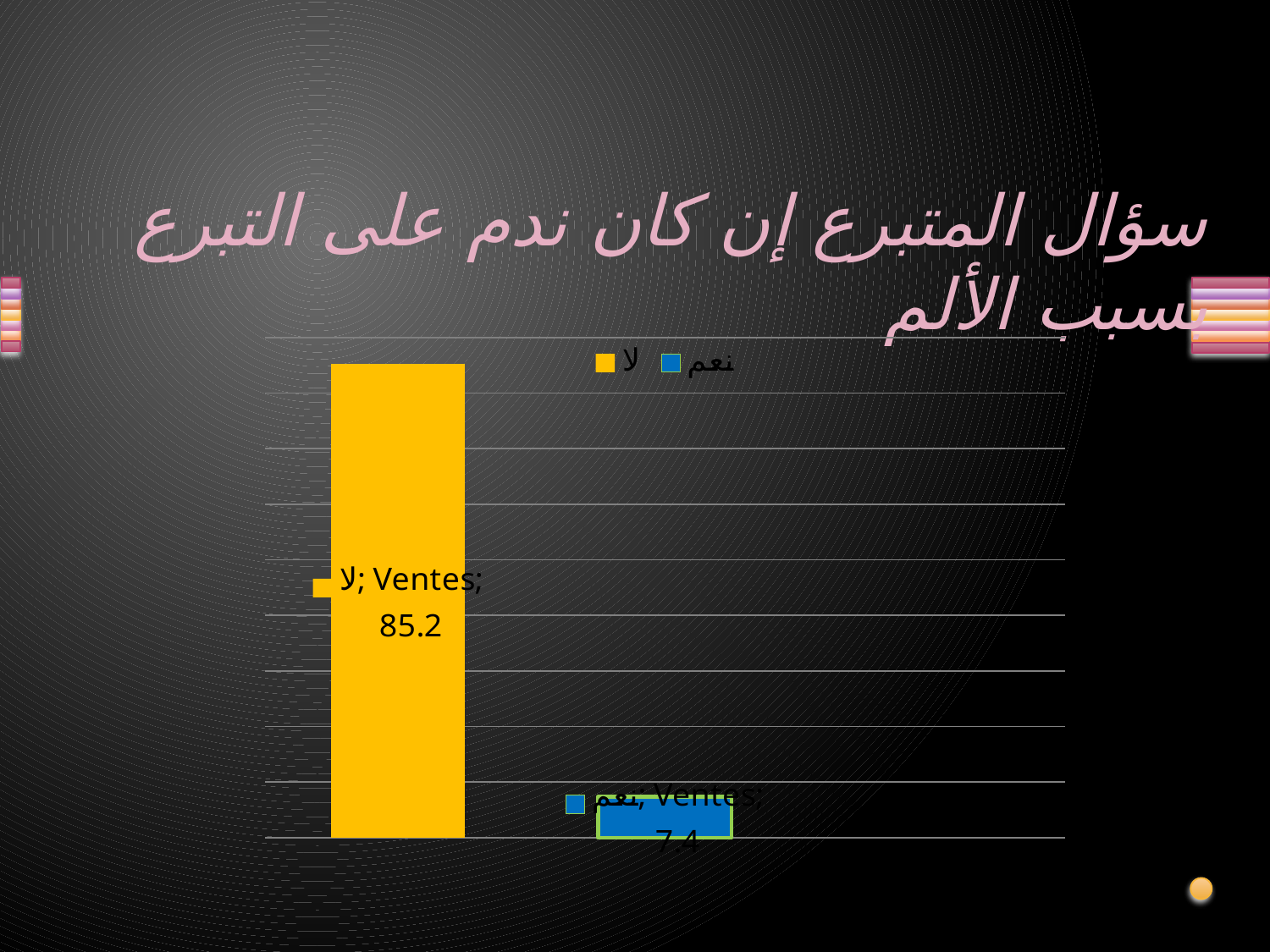
What kind of chart is shown on the slide? Bar chart What is the value for the category "لا" in the chart? 85.2 What colour is the bar for "لا"? Yellow What is the value for the category "نعم" in the chart? 7.4 Which category has the lowest value in the chart? نعم Which category has the highest value in the chart? لا What series name appears in the data labels of the chart? Ventes What colour is the bar for "نعم"? Blue Which is larger, the value for "لا" or the value for "نعم"? لا How many entries does the chart legend list? 2 What is the difference between the values for "لا" and "نعم"? 77.8 How many bars are plotted in the chart? 2